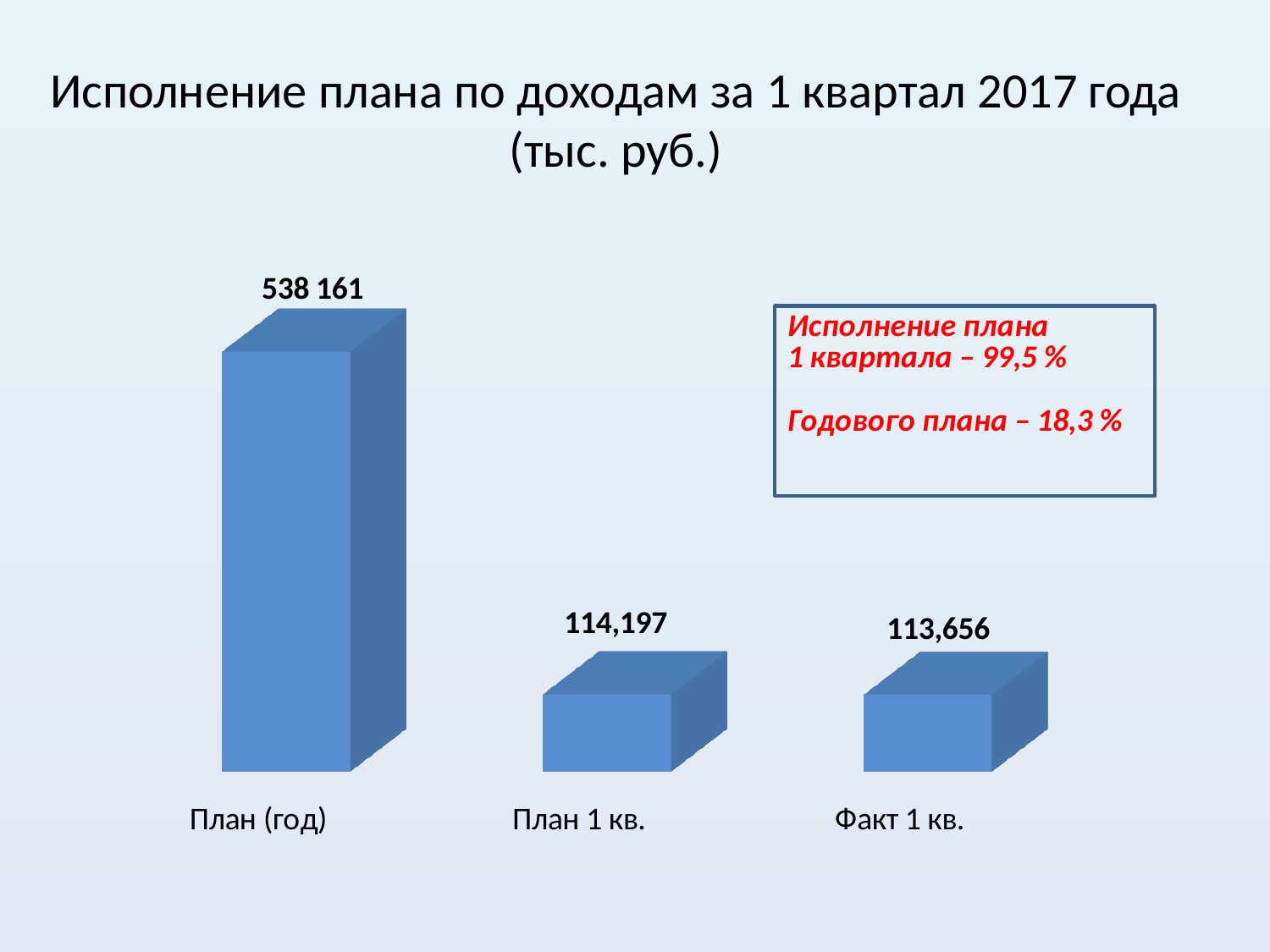
What is the value of the Факт 1 кв. bar? 113,656 What units are the values in, according to the title? тыс. руб. What is the title of the slide? Исполнение плана по доходам за 1 квартал 2017 года (тыс. руб.) Which category has the lowest value? Факт 1 кв. What is the value of the План (год) bar? 538 161 Which is larger, План 1 кв. or Факт 1 кв.? План 1 кв. Which is larger, План (год) or План 1 кв.? План (год) What is the value of the План 1 кв. bar? 114,197 Which category has the highest value? План (год) How many bars are shown in the chart? 3 According to the text box, what percentage of the 1st quarter plan was fulfilled? 99,5 % What type of chart is shown on the slide? Bar chart